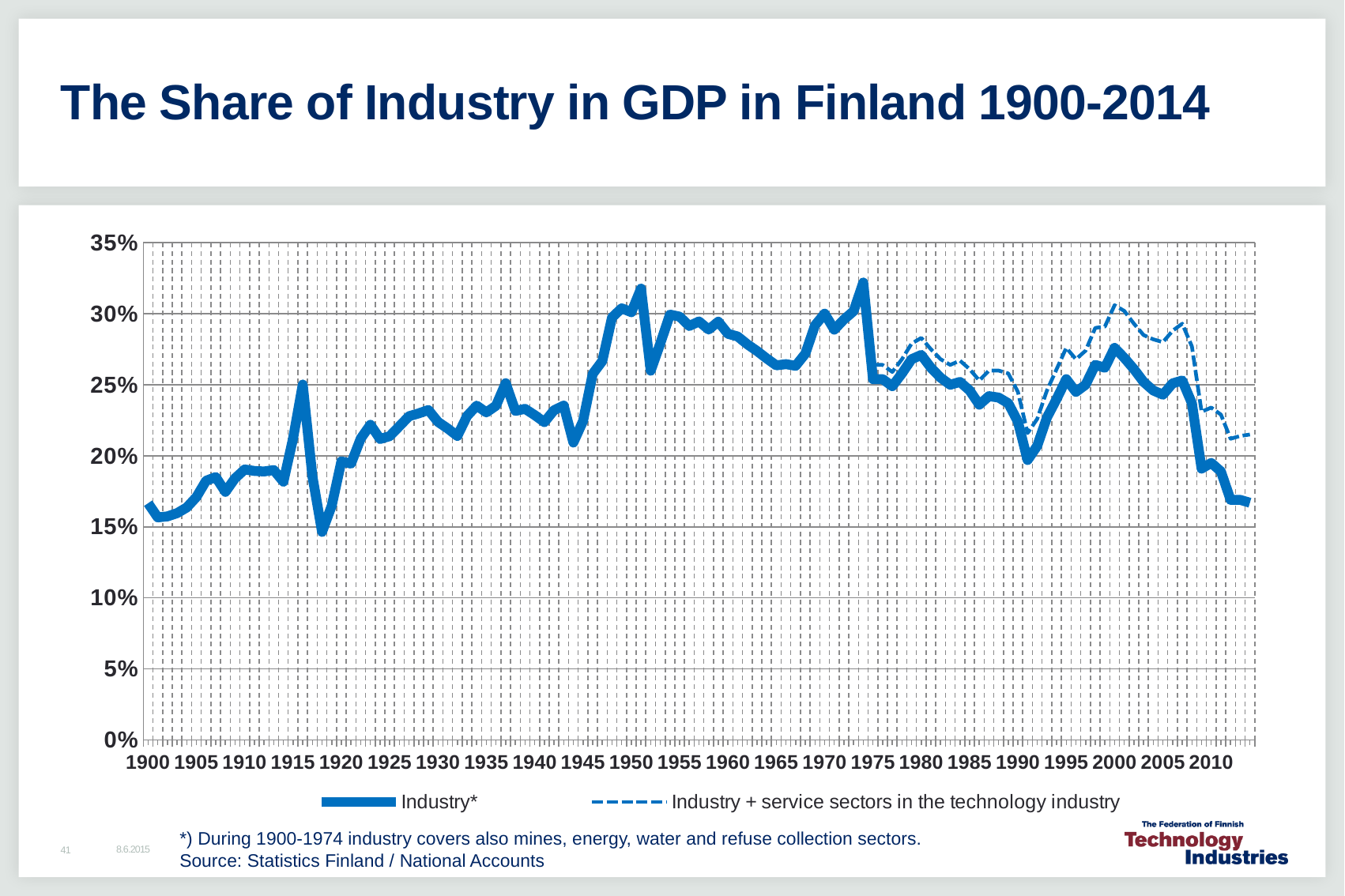
Which is larger, the Industry* share in 1974 or in 2014? 1974 In 2000, which series has the higher value, Industry* or Industry + service sectors in the technology industry? Industry + service sectors in the technology industry Does the Industry* share rise or fall between 2007 and 2014? fall How many series does the legend list? 2 Is the value for Industry* in 2014 greater or less than 20%? less Is the value for Industry* in 1900 greater or less than 20%? less Is the value for Industry + service sectors in the technology industry in 2000 greater or less than 25%? greater Which series is drawn with a dashed line? Industry + service sectors in the technology industry What is the title of the chart? The Share of Industry in GDP in Finland 1900-2014 What kind of chart is shown on the slide? line chart